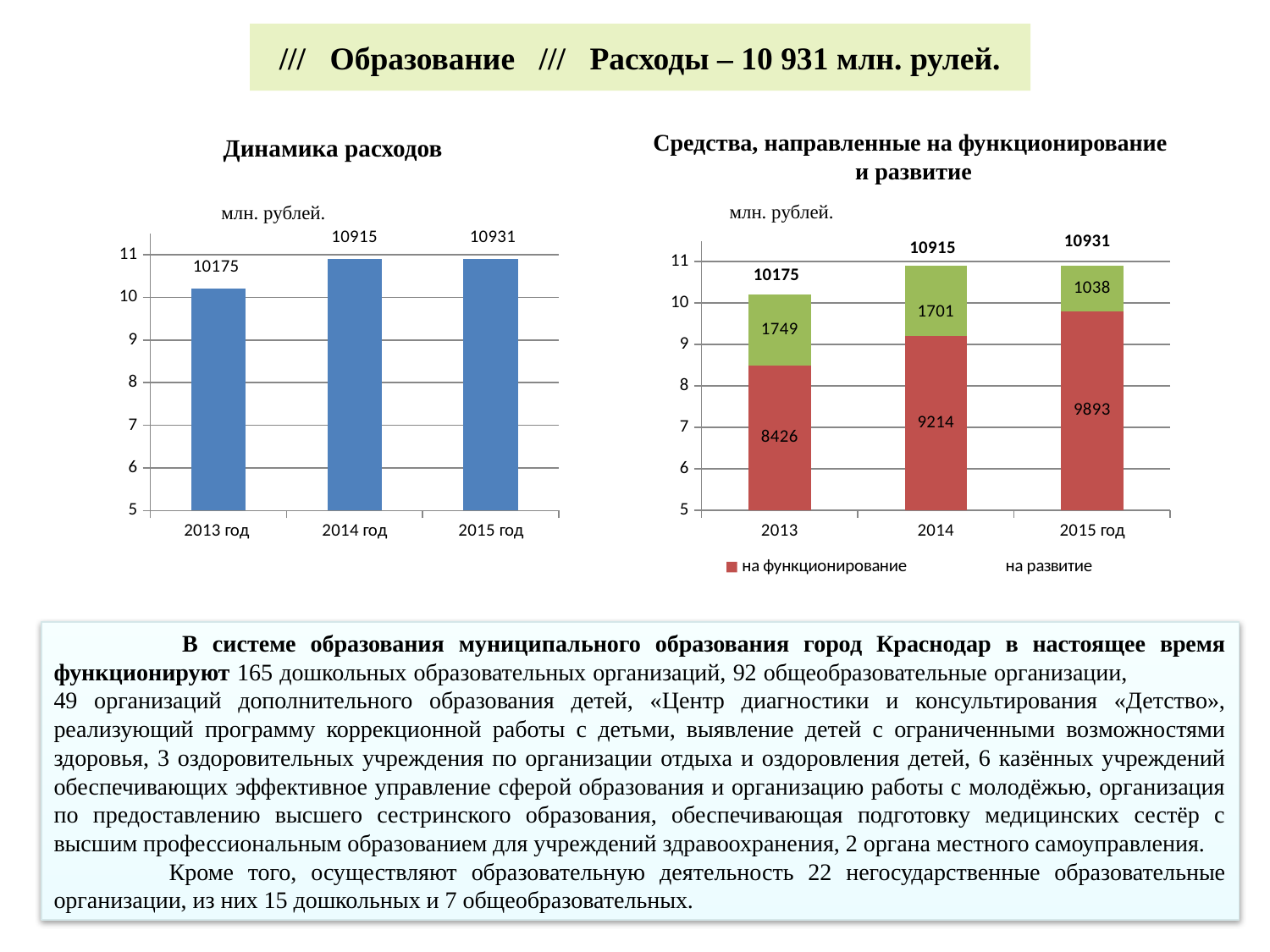
In the 'Средства, направленные на функционирование и развитие' chart, how many series does the legend list? 2 What kind of chart is 'Динамика расходов'? bar chart In the 'Средства, направленные на функционирование и развитие' chart, which is larger: 'на функционирование' in 2015 год or 'на функционирование' in 2013? 2015 год In the 'Динамика расходов' chart, do the values rise or fall from 2013 to 2015? rise In the 'Средства, направленные на функционирование и развитие' chart, what is the value for 'на функционирование' in 2014? 9214 In the 'Динамика расходов' chart, what is the value for 2013 год? 10175 In the 'Средства, направленные на функционирование и развитие' chart, which year has the highest value for 'на развитие'? 2013 In the 'Средства, направленные на функционирование и развитие' chart, what is the total of the stacked bar for 2013? 10175 In the 'Средства, направленные на функционирование и развитие' chart, what is the value for 'на развитие' in 2015 год? 1038 In the 'Динамика расходов' chart, how many bars are plotted? 3 In the 'Динамика расходов' chart, what is the difference between the values for 2015 год and 2013 год? 756 In the 'Динамика расходов' chart, which year has the lowest value? 2013 год